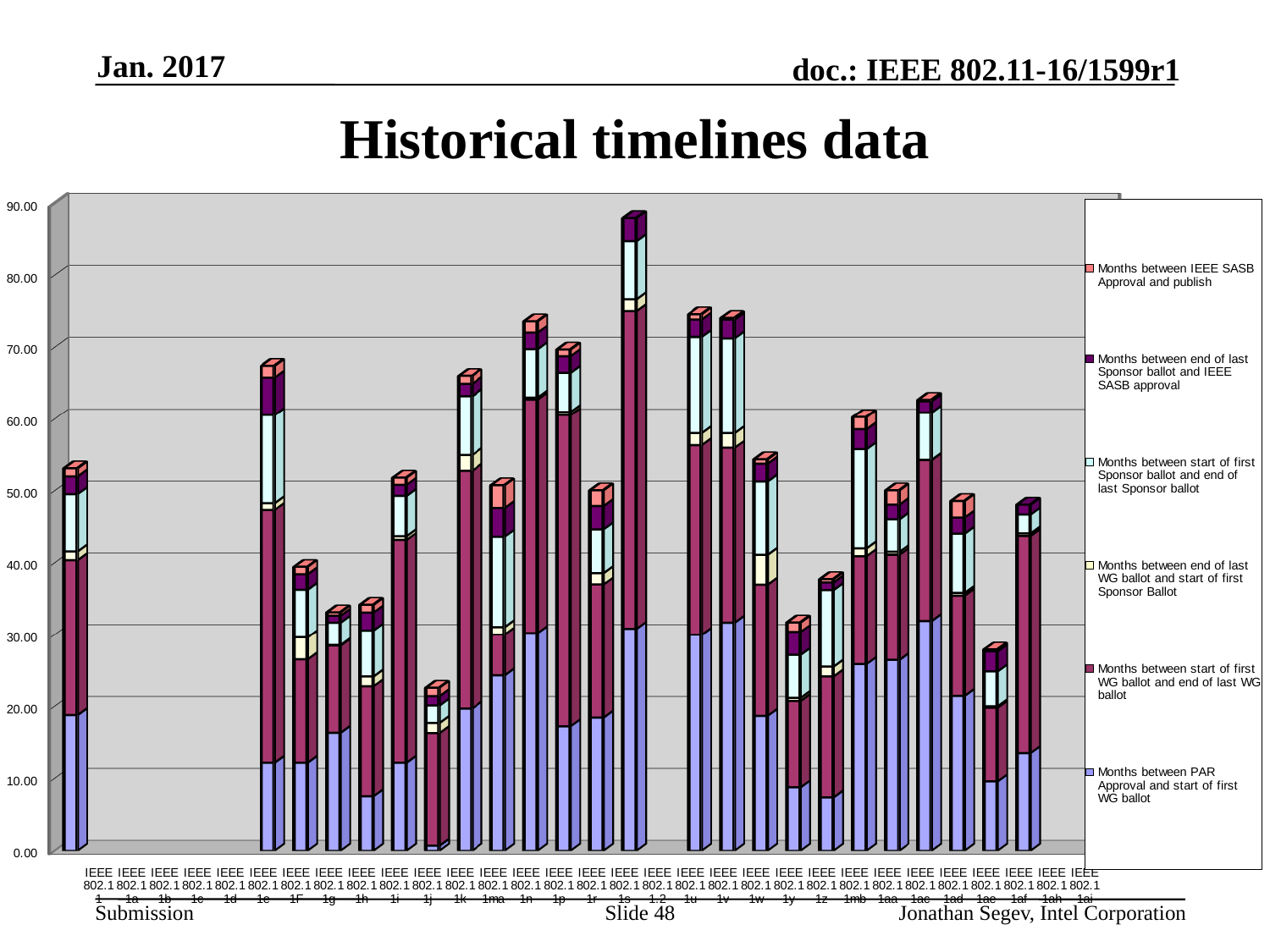
Is the total for IEEE 802.1 1ae greater or less than 30.00? less Is the total for IEEE 802.1 1e greater or less than 60.00? greater Is the total for IEEE 802.1 1u greater or less than 70.00? greater How many series does the legend list? 6 Which category has the shortest stacked bar? IEEE 802.11j Which has the taller stacked bar, IEEE 802.1 1e or IEEE 802.1 1F? IEEE 802.11e What kind of chart is shown on the slide? stacked bar chart What is the title of the chart? Historical timelines data Which category has the tallest stacked bar? IEEE 802.11s Which legend entry is listed last (at the bottom of the legend)? Months between PAR Approval and start of first WG ballot Which has the taller stacked bar, IEEE 802.1 1mb or IEEE 802.1 1aa? IEEE 802.11mb